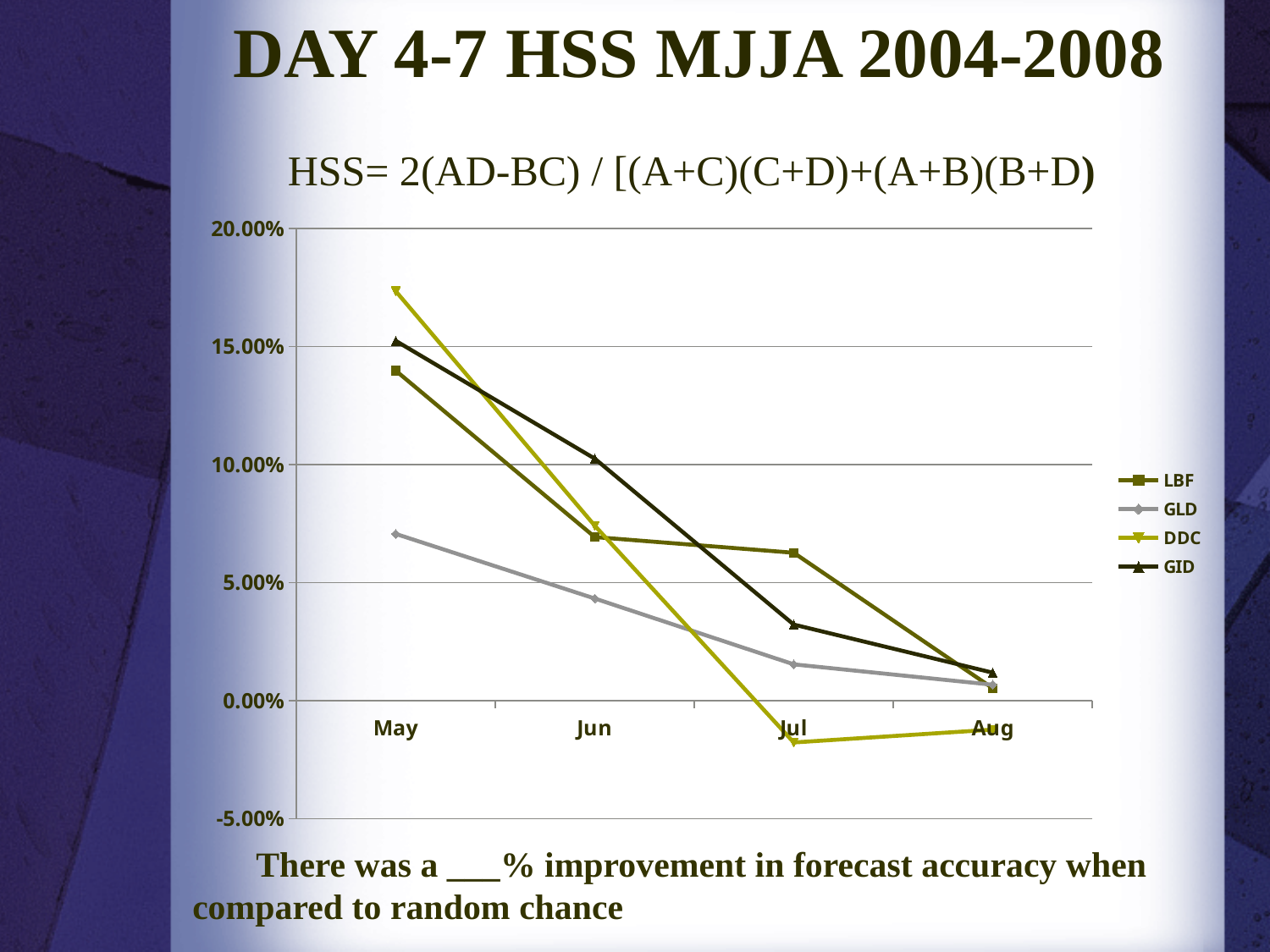
Is the value for DDC in May greater or less than 15.00%? greater Which series has the lowest value in May? GLD In Jul, which is larger, the value for LBF or the value for GID? LBF Does the DDC series rise or fall from May to Aug? fall Is the value for GLD in May greater or less than 10.00%? less How many months are shown along the x axis? 4 How many series does the legend list? 4 What is the title of the slide containing the chart? DAY 4-7 HSS MJJA 2004-2008 Which series has the lowest value in Jul? DDC Which series has the highest value in May? DDC What kind of chart is shown on the slide? line chart Is the value for DDC in Jul greater or less than 0.00%? less